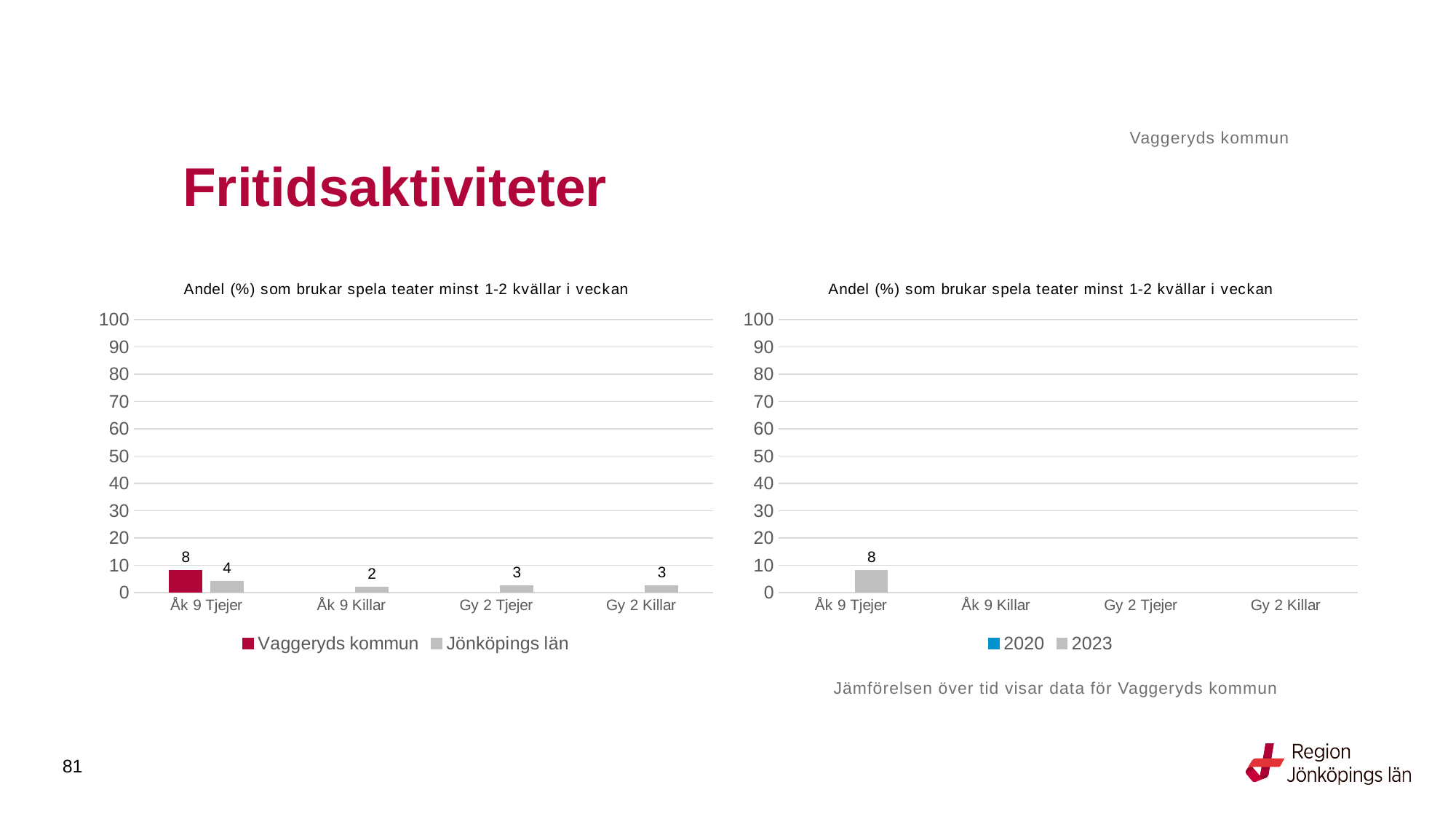
In the left chart, what is the value for Jönköpings län for Gy 2 Killar? 3 In the left chart, which category has the lowest value for Jönköpings län? Åk 9 Killar In the left chart, what is the value for Jönköpings län for Åk 9 Tjejer? 4 In the left chart, what is the value for Vaggeryds kommun for Åk 9 Tjejer? 8 In the left chart, which is larger for Åk 9 Tjejer: Vaggeryds kommun or Jönköpings län? Vaggeryds kommun How many categories are shown on the x axis of the right chart? 4 In the left chart, what is the value for Jönköpings län for Åk 9 Killar? 2 What kind of chart is the right chart? Bar chart What are the two series listed in the legend of the right chart? 2020 and 2023 In the left chart, what is the difference between Vaggeryds kommun and Jönköpings län for Åk 9 Tjejer? 4 In the right chart, what is the value for 2023 for Åk 9 Tjejer? 8 How many series does the legend of the left chart list? 2